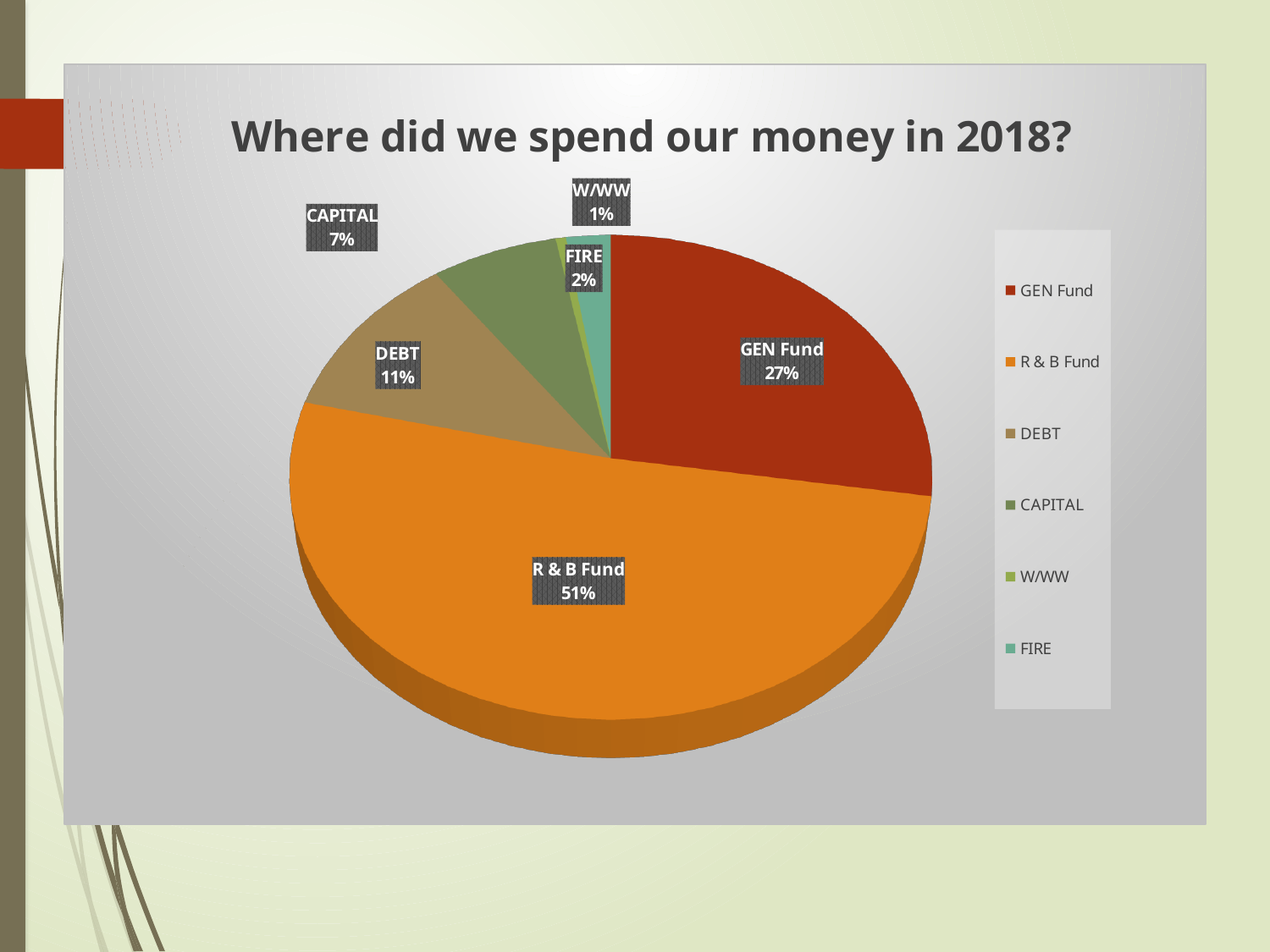
What percentage is shown for the GEN Fund slice? 27% Which category has the smallest slice of the pie? W/WW What share of spending does the R & B Fund slice represent? 51% How many categories are shown in the pie chart? 6 What is the combined percentage of the FIRE and W/WW slices? 3% What percentage is shown for CAPITAL? 7% What is the title of the chart? Where did we spend our money in 2018? Which category has the largest slice of the pie? R & B Fund What kind of chart is shown on the slide? Pie chart Which is larger, the DEBT slice or the CAPITAL slice? DEBT What is the difference in percentage points between the R & B Fund and the GEN Fund? 24 What percentage is shown for DEBT? 11%